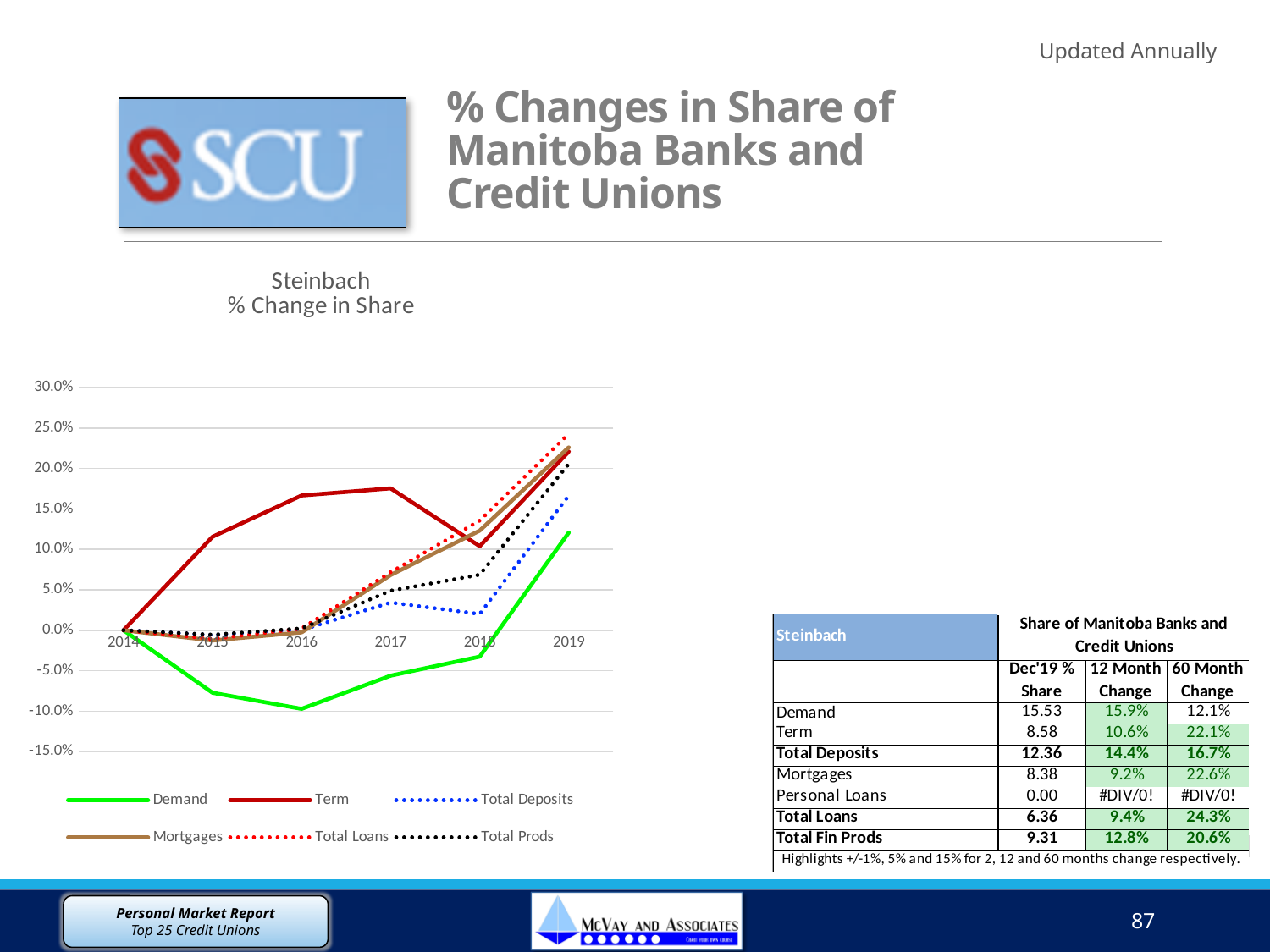
Which series has the highest value in 2017? Term Is the value for Demand in 2016 greater or less than -5.0%? less Is the value for Demand in 2019 greater or less than 10.0%? greater How many series does the legend of the chart list? 6 How many years are shown along the x axis of the chart? 6 What kind of chart is shown on the slide? line chart What is the title of the chart? Steinbach % Change in Share Which series is drawn as a solid green line in the chart? Demand Which series has the lowest value in 2016? Demand Is the value for Term in 2017 greater or less than 15.0%? greater Which is larger in 2015, the value for Term or the value for Demand? Term Does the Demand series rise or fall from 2014 to 2016? fall